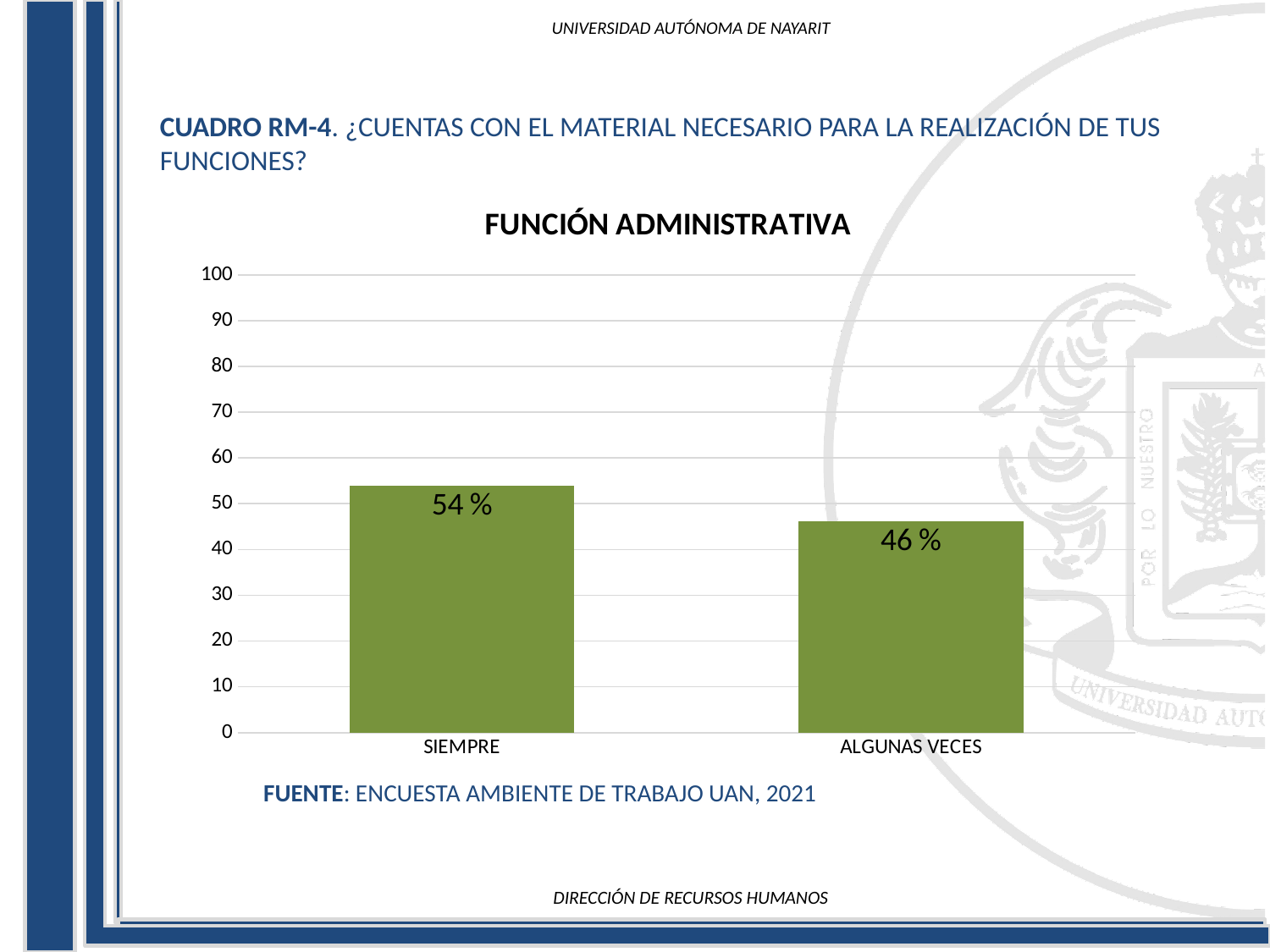
Is the value for SIEMPRE greater or less than 50? greater What is the difference between the values for SIEMPRE and ALGUNAS VECES? 8 % Which is larger, the value for SIEMPRE or the value for ALGUNAS VECES? SIEMPRE What is the value for SIEMPRE? 54 % Which category has the lowest value? ALGUNAS VECES Is the value for ALGUNAS VECES greater or less than 50? less What is the value for ALGUNAS VECES? 46 % What is the title of the chart? FUNCIÓN ADMINISTRATIVA What is the highest value shown on the vertical axis? 100 Which category has the highest value? SIEMPRE What kind of chart is shown on the slide? bar chart How many categories are shown on the chart? 2